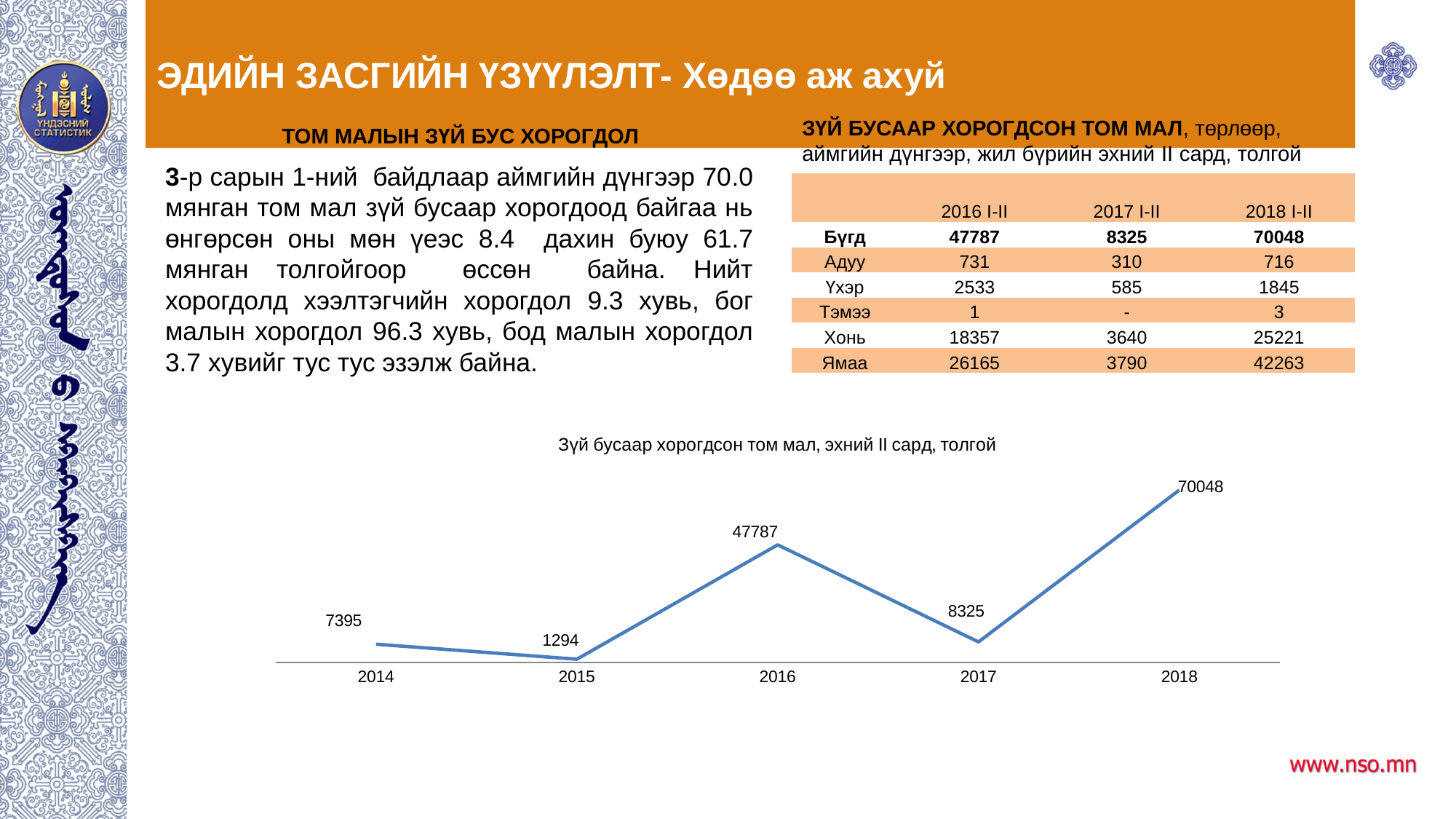
Which year has the lowest value in the line chart? 2015 What is the value for 2017 in the line chart? 8325 What is the difference between the values for 2016 and 2015 in the line chart? 46493 Does the value rise or fall from 2016 to 2017 in the line chart? fall Which year has the highest value in the line chart? 2018 What is the value for 2014 in the line chart? 7395 Which is larger in the line chart, the value for 2014 or the value for 2017? 2017 How many years are plotted in the line chart? 5 What is the difference between the values for 2018 and 2017 in the line chart? 61723 What type of chart is shown on the slide? line chart What is the value for 2016 in the line chart? 47787 What is the title of the line chart? Зүй бусаар хорогдсон том мал, эхний II сард, толгой